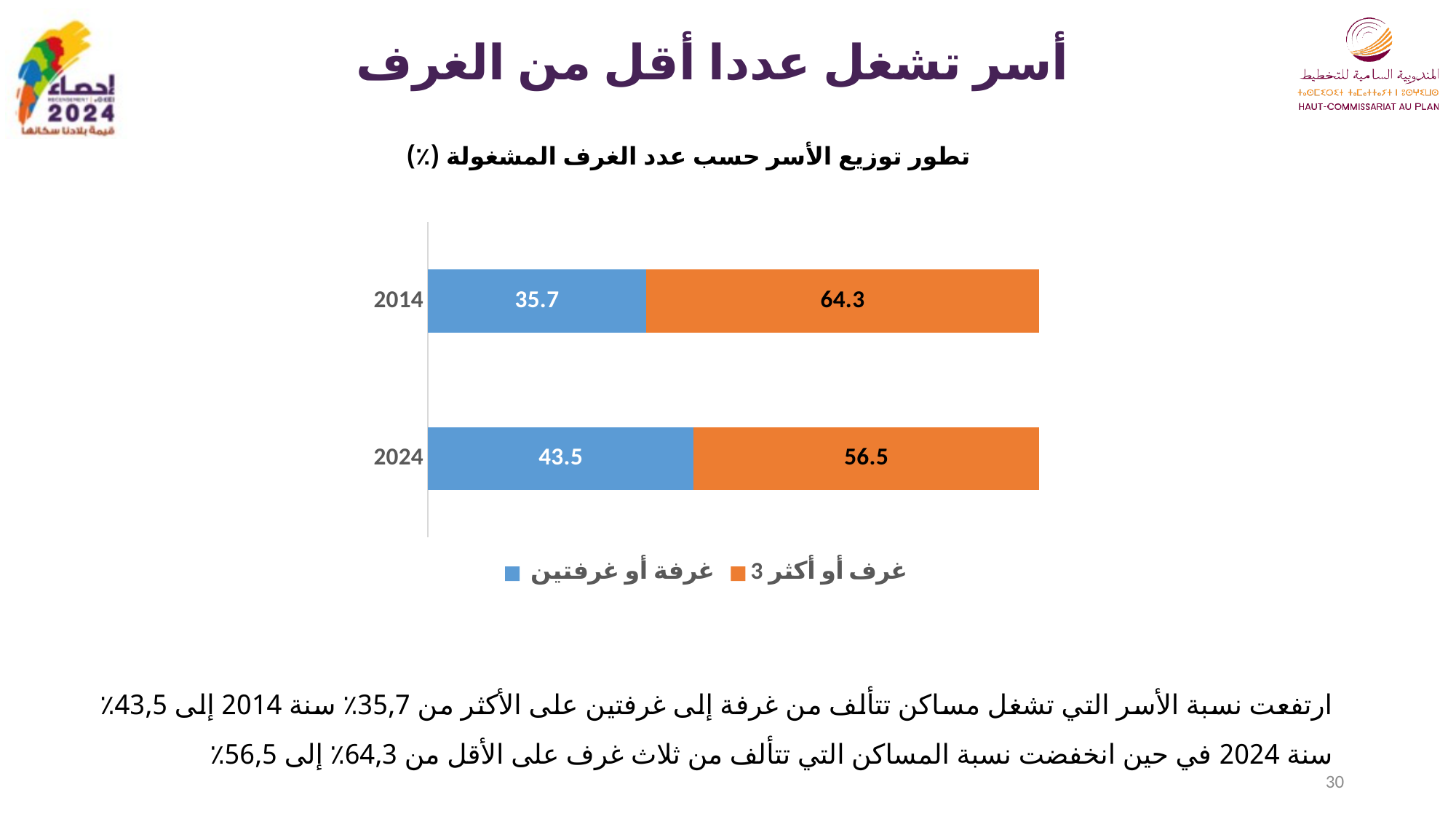
How many series does the legend list? 2 What is the value for "غرفة أو غرفتين" in 2024? 43.5 What is the difference between the "غرفة أو غرفتين" values for 2024 and 2014? 7.8 Which is larger in 2014: "غرفة أو غرفتين" or "3 غرف أو أكثر"? 3 غرف أو أكثر What is the total of the stacked bar for 2024? 100 In which year is the value for "3 غرف أو أكثر" lower? 2024 What is the value for "3 غرف أو أكثر" in 2024? 56.5 What kind of chart is shown on the slide? Stacked bar chart What is the value for "3 غرف أو أكثر" in 2014? 64.3 In which year is the value for "غرفة أو غرفتين" higher? 2024 What is the value for "غرفة أو غرفتين" in 2014? 35.7 How many years (categories) are shown on the chart? 2